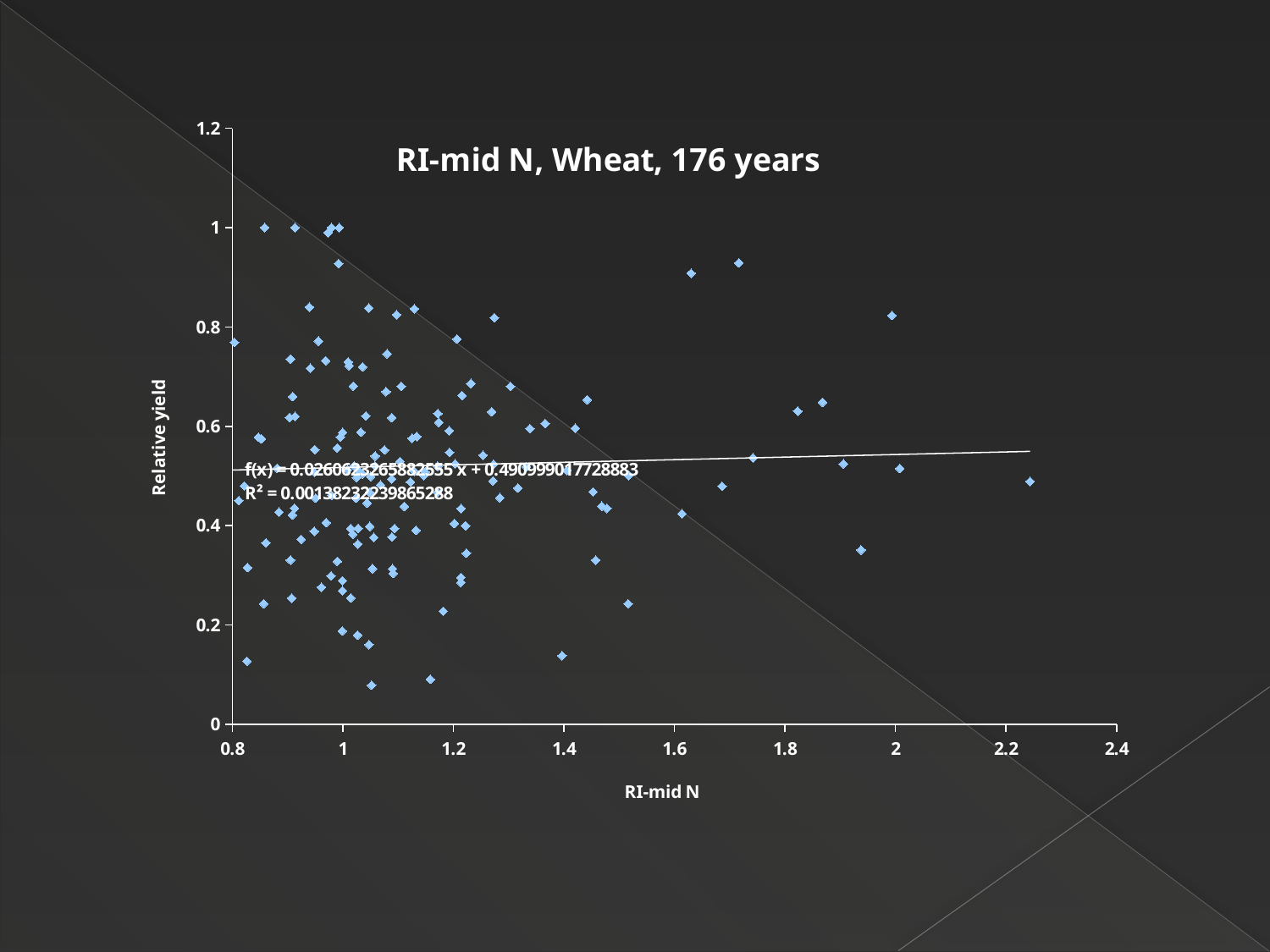
What is the title of the chart? RI-mid N, Wheat, 176 years What R² value is printed on the chart? R² = 0.00138232239865288 Is the relative yield of the highest points on the chart greater or less than 0.9? greater Is the relative yield of the rightmost point (near RI-mid N of 2.24) greater or less than 0.6? less What is the label of the y axis? Relative yield Is the relative yield of the point at RI-mid N of about 2.0 (the highest point on the right side) greater or less than 0.8? greater What is the maximum value shown on the y axis? 1.2 Does the fitted trendline rise or fall as RI-mid N increases? Rises slightly What is the maximum value shown on the x axis? 2.4 What kind of chart is shown on the slide? Scatter plot